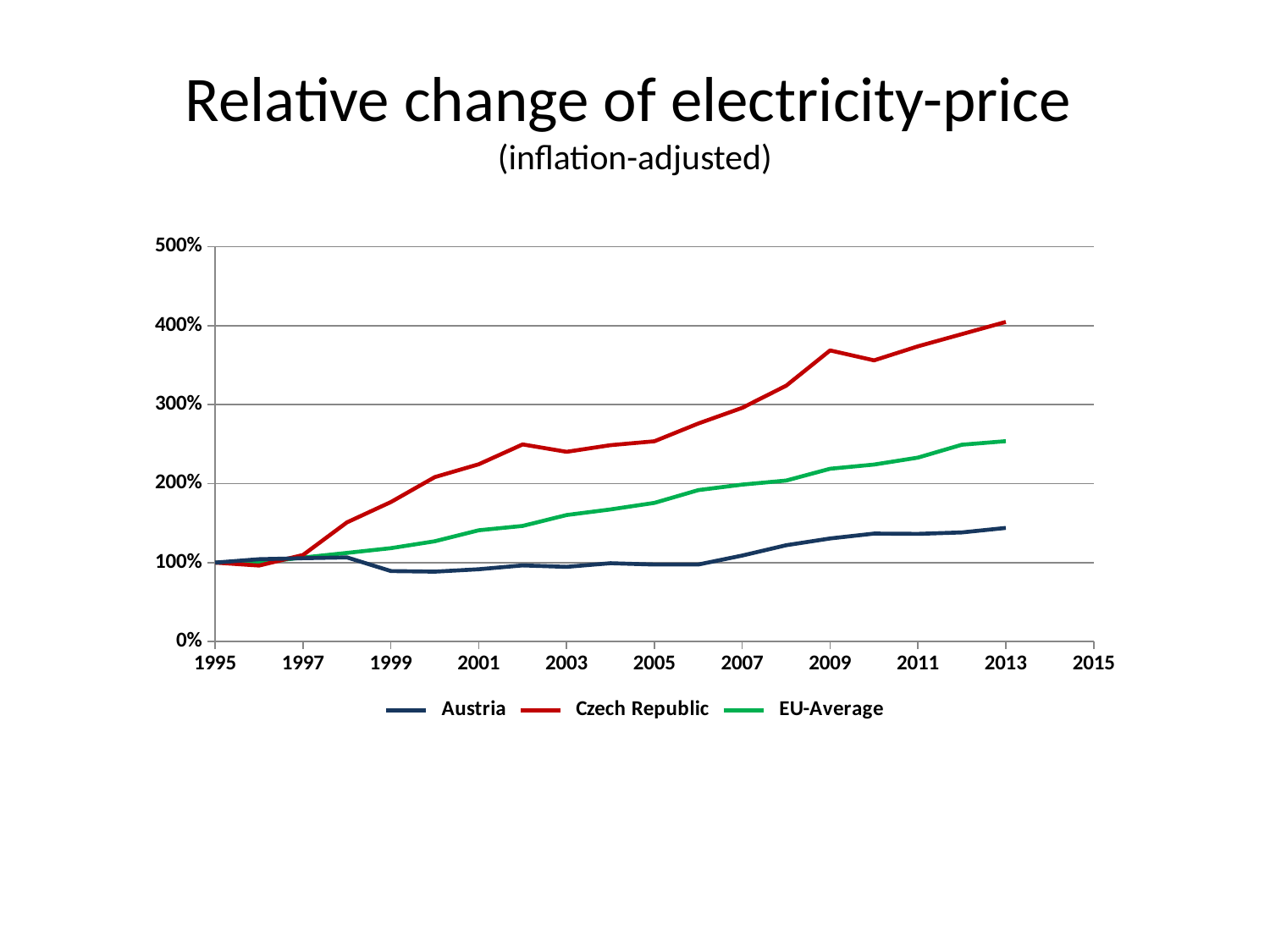
Is the value for EU-Average in 2005 greater or less than 200%? less Is the value for EU-Average in 2013 greater or less than 200%? greater Does the Czech Republic line generally rise or fall from 1997 to 2013? rise What kind of chart is shown on the slide? line chart Which series has the lowest value in 2013? Austria Is the value for Czech Republic in 2009 greater or less than 300%? greater How many series does the legend list? 3 Which series are listed in the legend? Austria, Czech Republic, EU-Average What is the title of the chart on the slide? Relative change of electricity-price (inflation-adjusted) Which series has the highest value in 2013? Czech Republic In 2009, which is larger: the value for EU-Average or the value for Austria? EU-Average